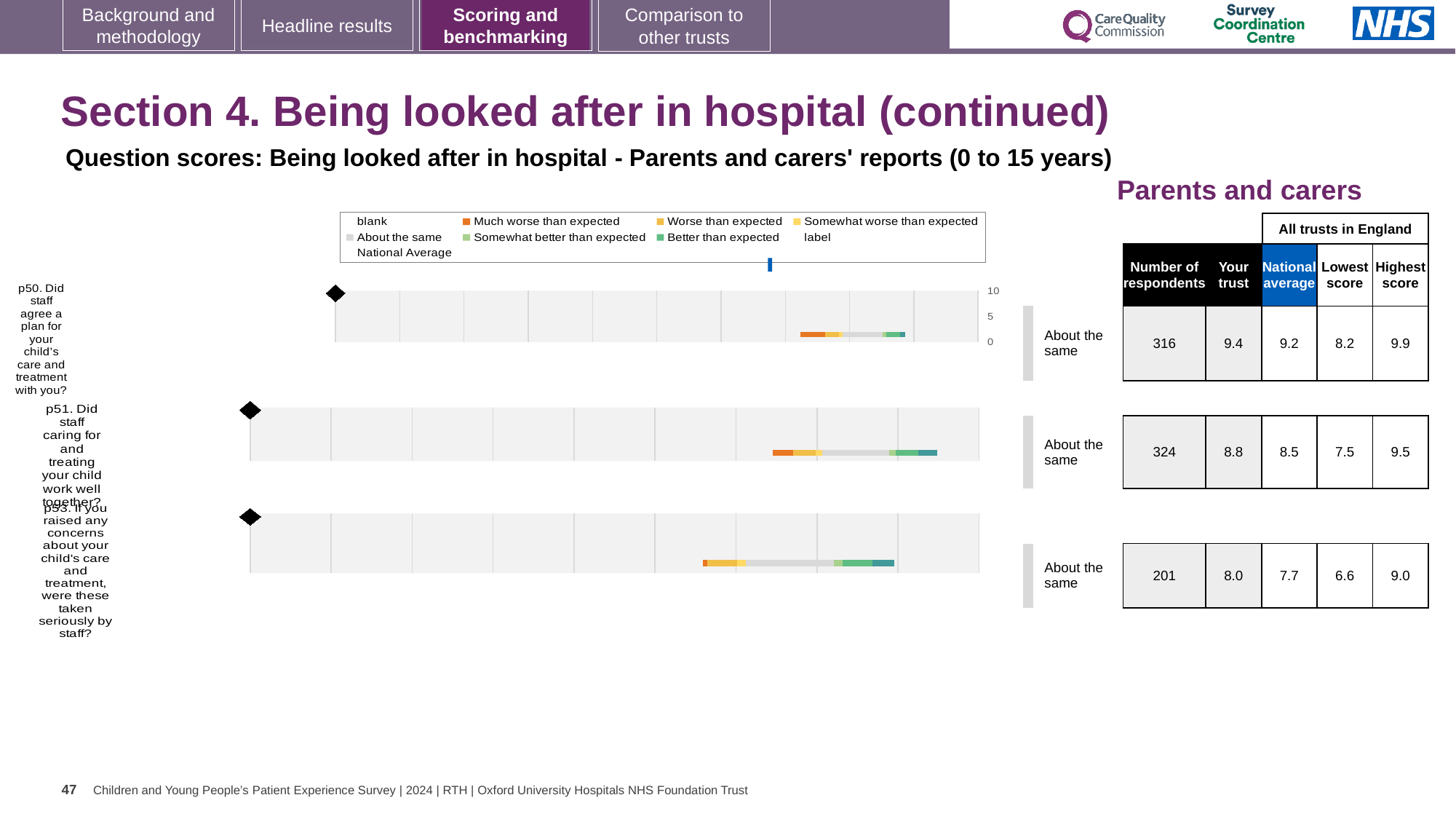
For p50, what is the difference between the 'Your trust' score and the national average? 0.2 For the p50 chart (Did staff agree a plan for your child's care and treatment with you?), what is the 'Your trust' score? 9.4 What benchmark category is shown for all three questions (p50, p51, p53)? About the same In the legend, which colour represents 'Much worse than expected'? orange For the p51 chart (Did staff caring for and treating your child work well together?), what is the national average score? 8.5 Which question has the highest 'Your trust' score? p50 For p53, what is the highest score among all trusts in England? 9.0 For p51, which is larger: the 'Your trust' score or the national average? Your trust For the p53 chart (If you raised any concerns about your child's care and treatment, were these taken seriously by staff?), how many respondents were there? 201 What kind of chart is used for each question (p50, p51, p53)? bar chart Which question has the lowest national average score? p53 How many question charts are shown on the slide? 3